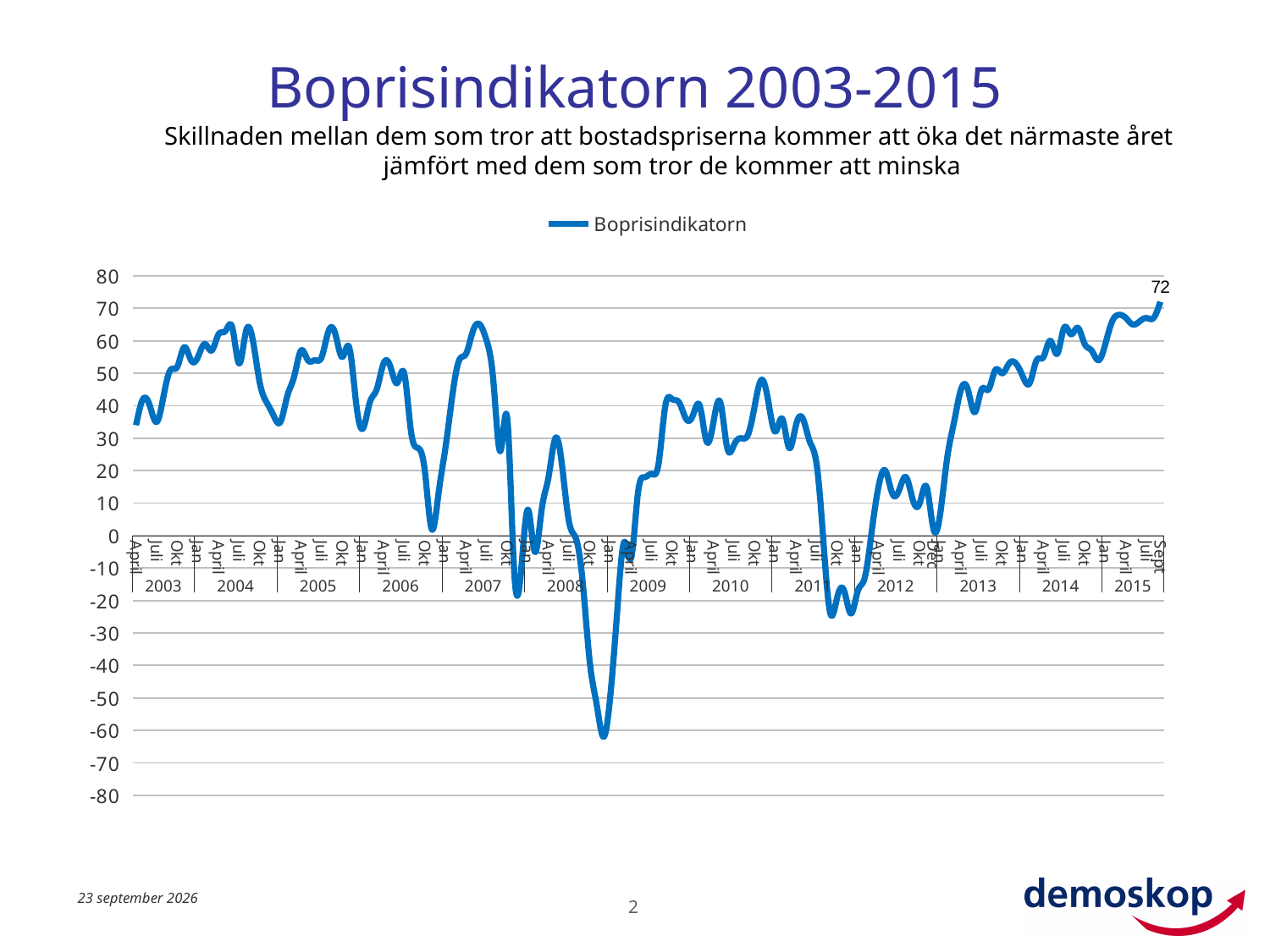
Does the line rise or fall from mid-2007 to Jan 2009? fall Does the line generally rise or fall from Jan 2013 to Sept 2015? rise What is the name of the series shown in the legend? Boprisindikatorn What is the value of Boprisindikatorn at the last point, Sept 2015? 72 Is the value for Okt 2011 greater or less than -10? less How many series does the legend list? 1 Is the value for April 2003 greater or less than 20? greater Is the value for Juli 2012 greater or less than 30? less In which year does the line reach its highest point? 2015 What kind of chart is shown on the slide? line chart In which year does the line reach its lowest point? 2008